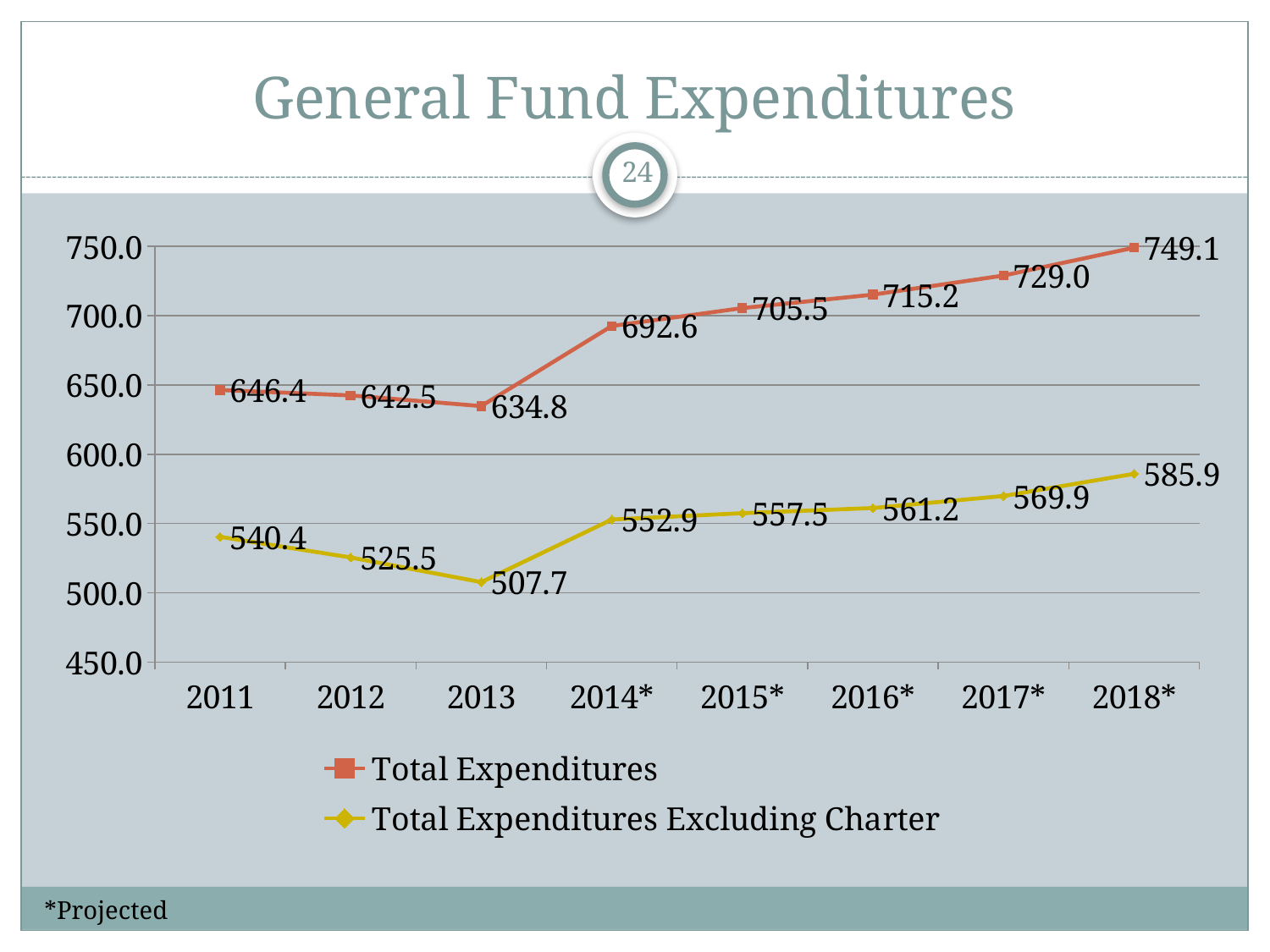
What is the value of Total Expenditures Excluding Charter in 2016*? 561.2 How many series does the legend list? 2 In which year is Total Expenditures Excluding Charter lowest? 2013 In which year is Total Expenditures highest? 2018* Is the value for Total Expenditures Excluding Charter in 2018* greater or less than 600.0? less What kind of chart is shown on the slide? line chart Which is larger: Total Expenditures in 2014* or Total Expenditures in 2015*? 2015* What is the difference between Total Expenditures and Total Expenditures Excluding Charter in 2011? 106.0 Does Total Expenditures rise or fall from 2013 to 2018*? rise How many years are shown on the x axis? 8 What is the value of Total Expenditures in 2013? 634.8 What is the title of the chart? General Fund Expenditures